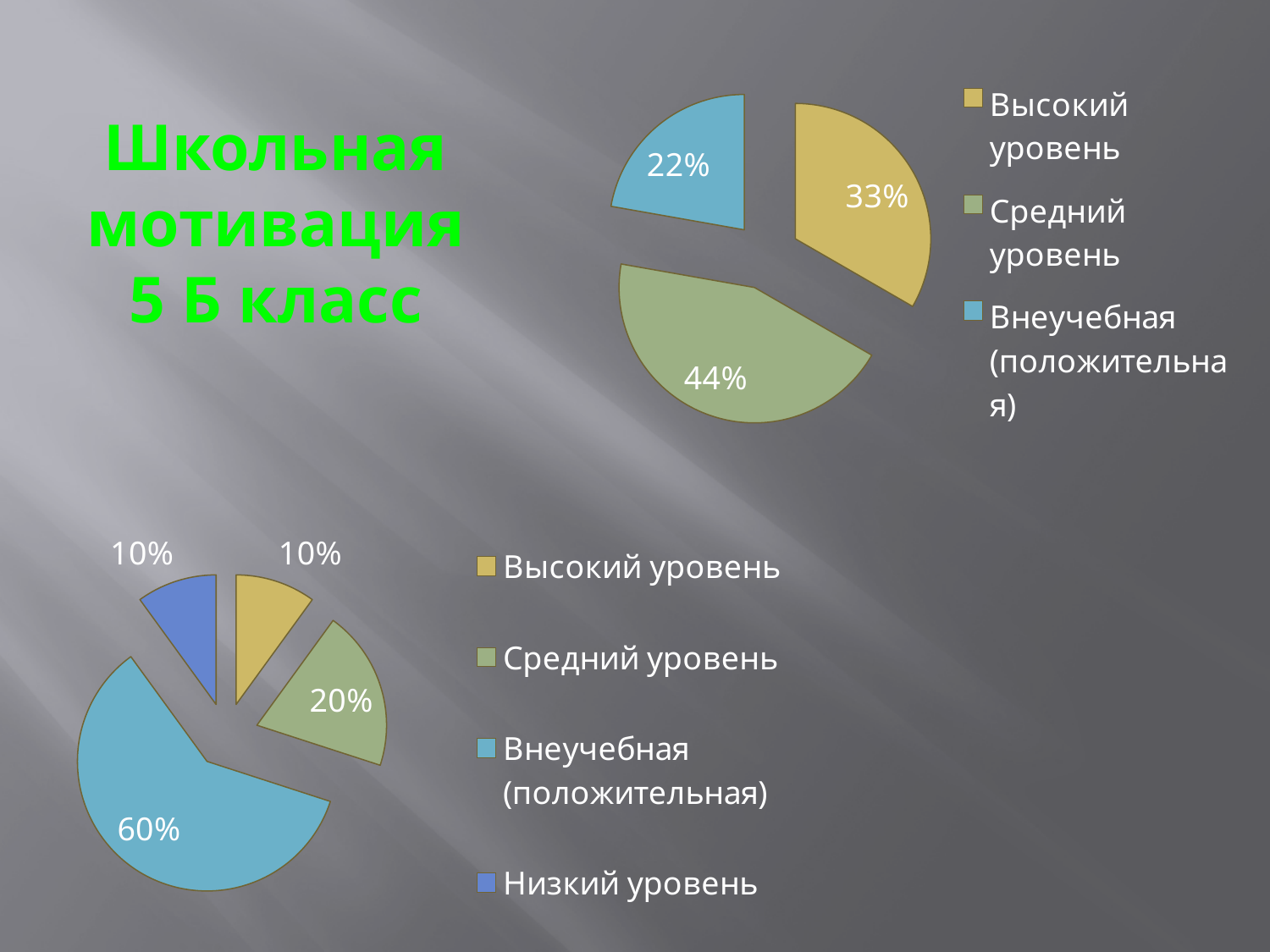
In the pie chart at the top right of the slide, which category has the largest slice? Средний уровень In the pie chart at the top right of the slide, how many categories does the legend list? 3 In the pie chart at the top right of the slide, which category has the smallest slice? Внеучебная (положительная) In the pie chart at the top right of the slide, what share does Средний уровень have? 44% What kind of chart is shown at the bottom left of the slide? Pie chart In the pie chart at the bottom left of the slide, what share does Средний уровень have? 20% In the pie chart at the top right of the slide, what is the difference between the shares of Высокий уровень and Внеучебная (положительная)? 11% In the pie chart at the top right of the slide, what share does Внеучебная (положительная) have? 22% In the pie chart at the bottom left of the slide, which category has the largest slice? Внеучебная (положительная) In the pie chart at the bottom left of the slide, how many categories does the legend list? 4 In the pie chart at the bottom left of the slide, what share does Внеучебная (положительная) have? 60% In the pie chart at the bottom left of the slide, which is larger: Средний уровень or Низкий уровень? Средний уровень